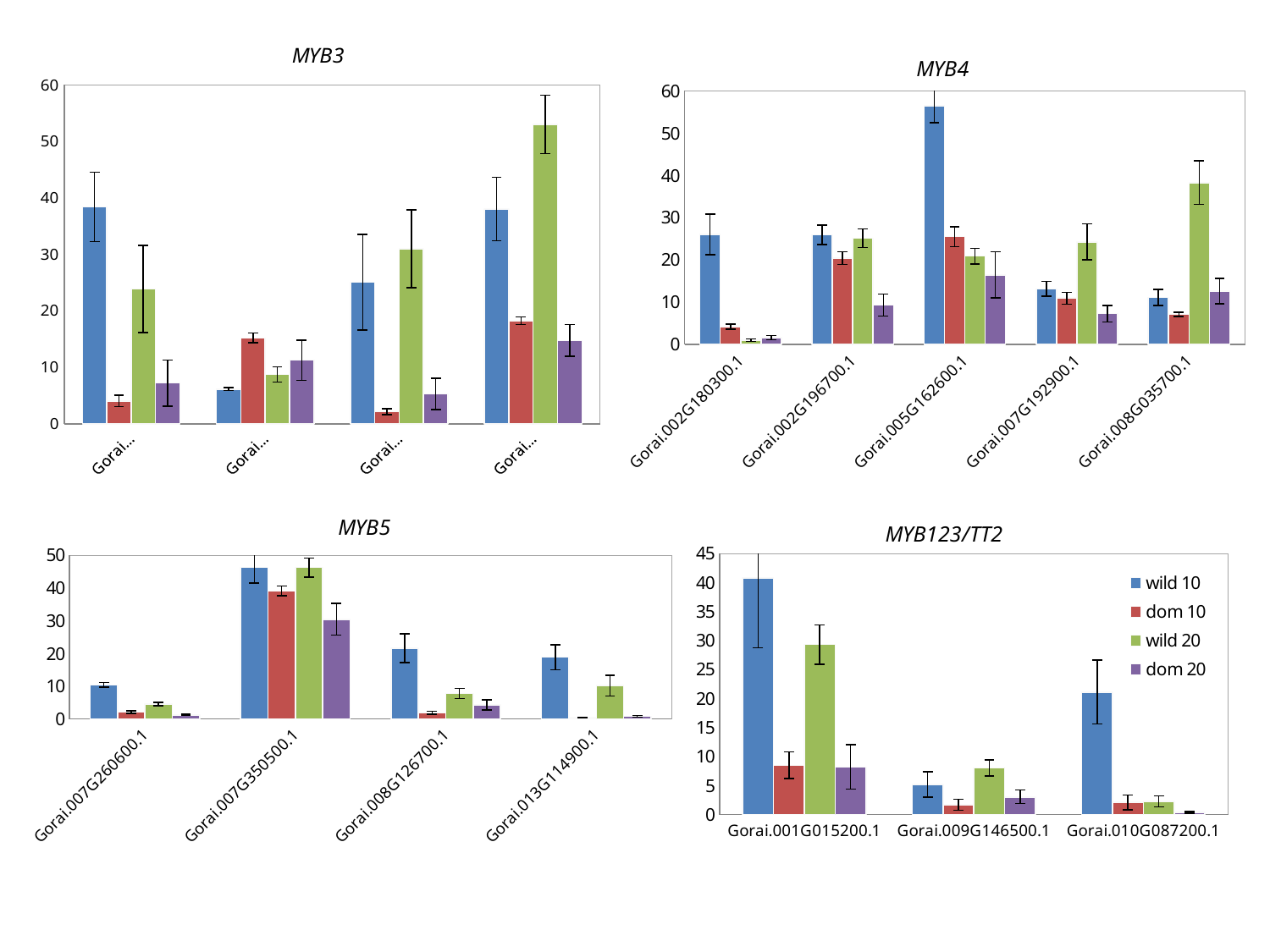
In the MYB4 chart, is the wild 10 value for Gorai.005G162600.1 greater or less than 50? greater In the MYB123/TT2 chart, which series is shown in blue according to the legend? wild 10 In the MYB5 chart, which category has the highest wild 10 value? Gorai.007G350500.1 In the MYB4 chart, which category has the highest wild 10 value? Gorai.005G162600.1 What kind of chart is the MYB5 chart? bar chart In the MYB123/TT2 chart, is the wild 20 value for Gorai.001G015200.1 greater or less than 20? greater In the MYB123/TT2 chart, which category has the highest wild 10 value? Gorai.001G015200.1 In the MYB123/TT2 chart, which has the larger wild 10 value, Gorai.001G015200.1 or Gorai.010G087200.1? Gorai.001G015200.1 In the MYB3 chart, how many categories are shown on the x axis? 4 In the MYB4 chart, how many categories are shown on the x axis? 5 In the MYB123/TT2 chart, how many series does the legend list? 4 In the MYB5 chart, is the wild 10 value for Gorai.007G260600.1 greater or less than 20? less